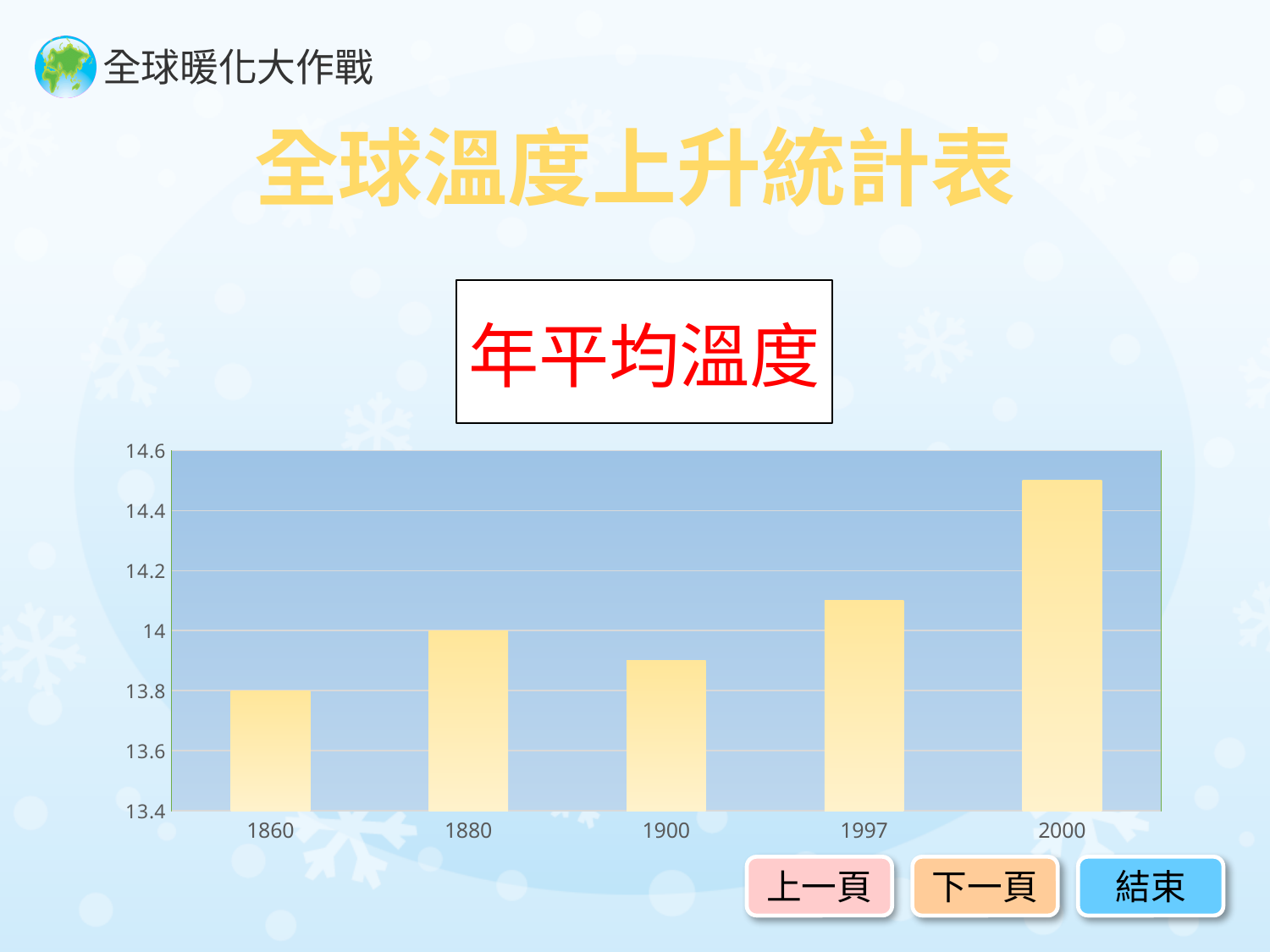
Is the value for 2000 greater or less than 14.4? greater How many years (categories) are shown on the x axis of the chart? 5 Is the value for 1900 greater or less than 14? less What is the value for 1860? 13.8 Does the value rise or fall from 1997 to 2000? rise What is the value for 1880? 14 Which is larger, the value for 2000 or the value for 1997? 2000 What type of chart is shown on the slide? bar chart Which year has the highest bar? 2000 What is the title shown in the box above the chart? 年平均溫度 What is the difference between the values for 1880 and 1860? 0.2 Which year has the lowest bar? 1860